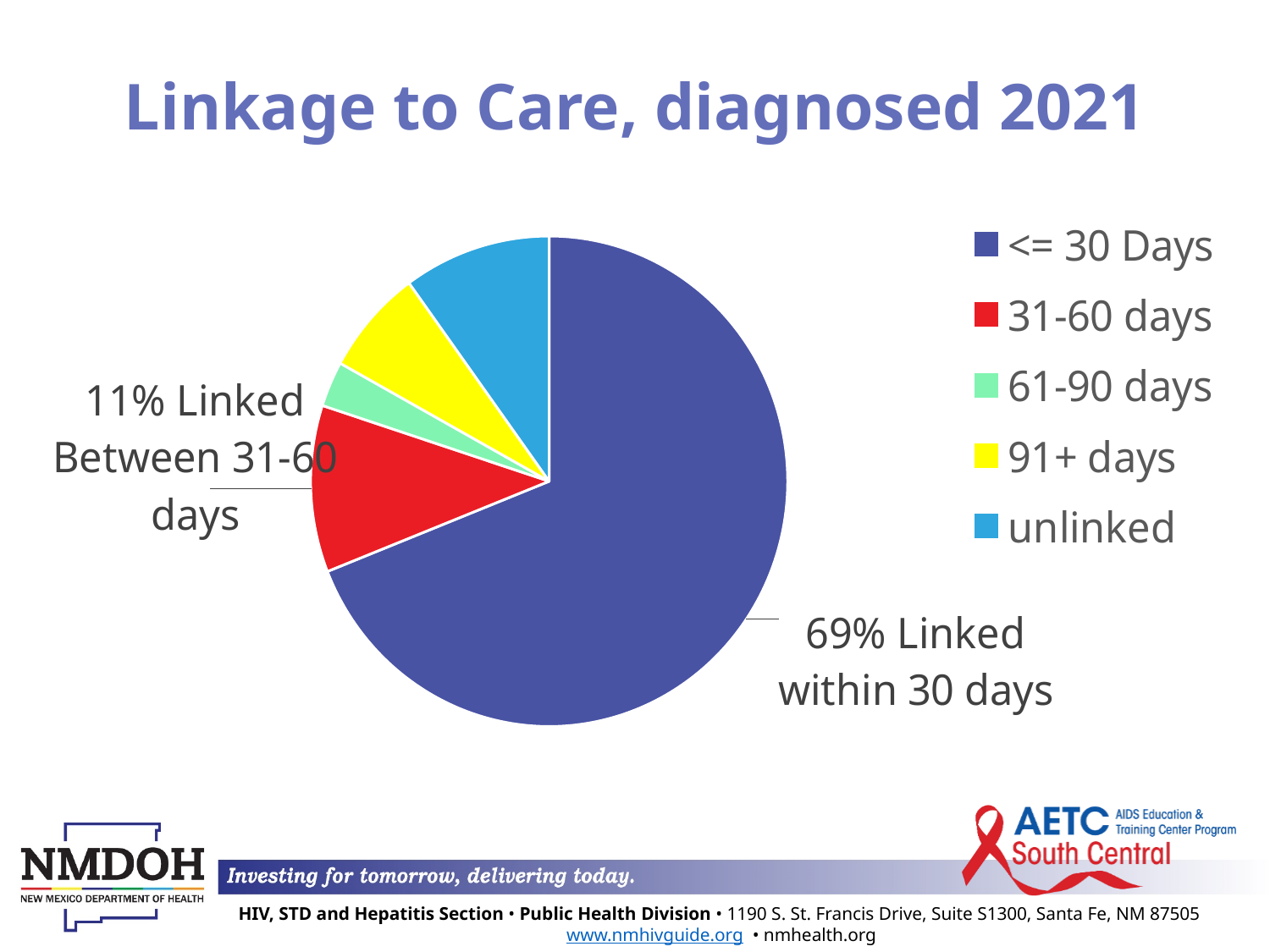
What percentage of people diagnosed in 2021 were linked to care within 30 days? 69% How many categories does the pie chart show? 5 Which is larger: the share linked within 30 days or the share linked between 31-60 days? <= 30 Days Which slice is larger: 91+ days or 61-90 days? 91+ days How many entries are listed in the legend? 5 What percentage were linked to care between 31-60 days? 11% Which category has the smallest slice of the pie? 61-90 days What is the difference in percentage points between the share linked within 30 days and the share linked between 31-60 days? 58 percentage points What colour represents the unlinked category in the pie chart? Light blue What kind of chart is shown on the slide? Pie chart Which category has the largest slice of the pie? <= 30 Days What is the title of the chart? Linkage to Care, diagnosed 2021